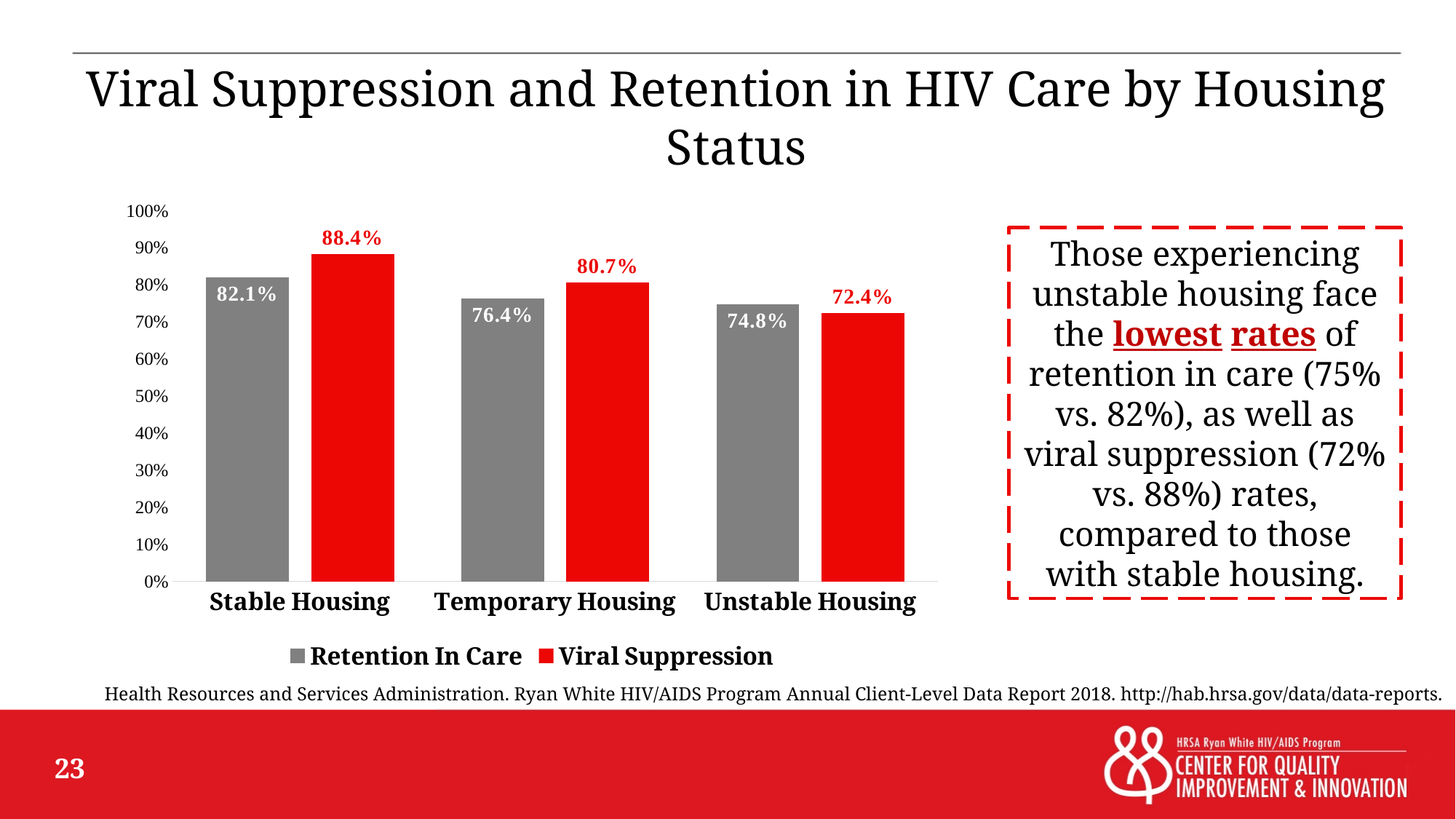
What is the Viral Suppression value for Temporary Housing? 80.7% Which housing status has the highest Viral Suppression value? Stable Housing What is the Viral Suppression value for Unstable Housing? 72.4% Which is larger for Unstable Housing: Retention In Care or Viral Suppression? Retention In Care What kind of chart is shown on the slide? Bar chart Which housing status has the lowest Retention In Care value? Unstable Housing What is the difference between the Viral Suppression values for Stable Housing and Unstable Housing? 16.0% What is the Retention In Care value for Stable Housing? 82.1% How many housing status categories are shown on the x axis? 3 What colour are the Viral Suppression bars? Red Do the Viral Suppression values rise or fall from Stable Housing to Unstable Housing? Fall How many series does the legend list? 2